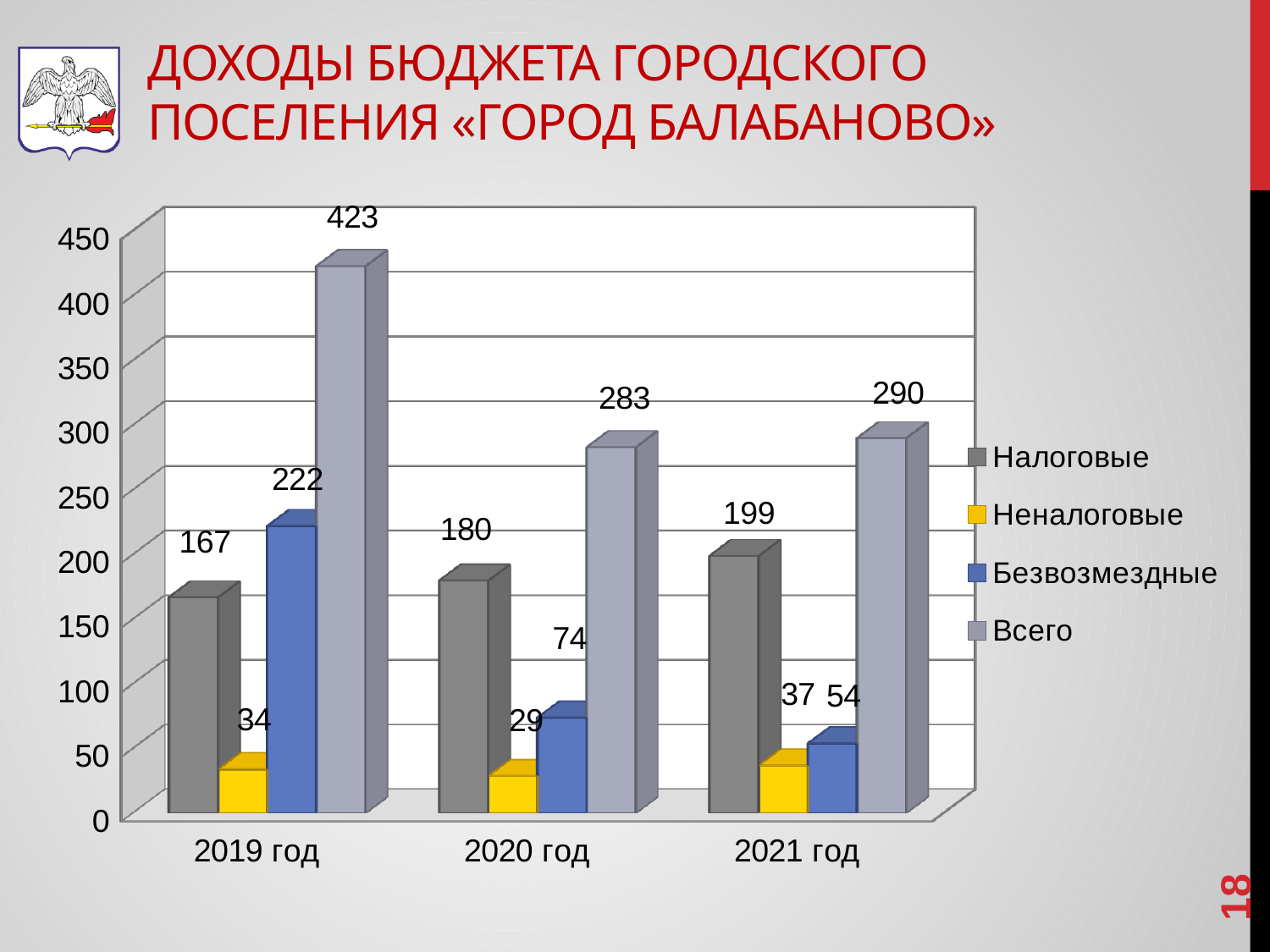
What is the difference between Всего in 2019 год and Всего in 2021 год? 133 What is the value of Налоговые for 2019 год? 167 What is the value of Всего for 2020 год? 283 What is the value of Безвозмездные for 2021 год? 54 In which year is Всего the highest? 2019 год In which year is Неналоговые the lowest? 2020 год How many years are shown on the x axis? 3 What is the value of Неналоговые for 2020 год? 29 What kind of chart is shown on the slide? bar chart How many series does the legend list? 4 Do the values of Налоговые rise or fall from 2019 год to 2021 год? rise Which is larger: Безвозмездные in 2019 год or Налоговые in 2019 год? Безвозмездные in 2019 год